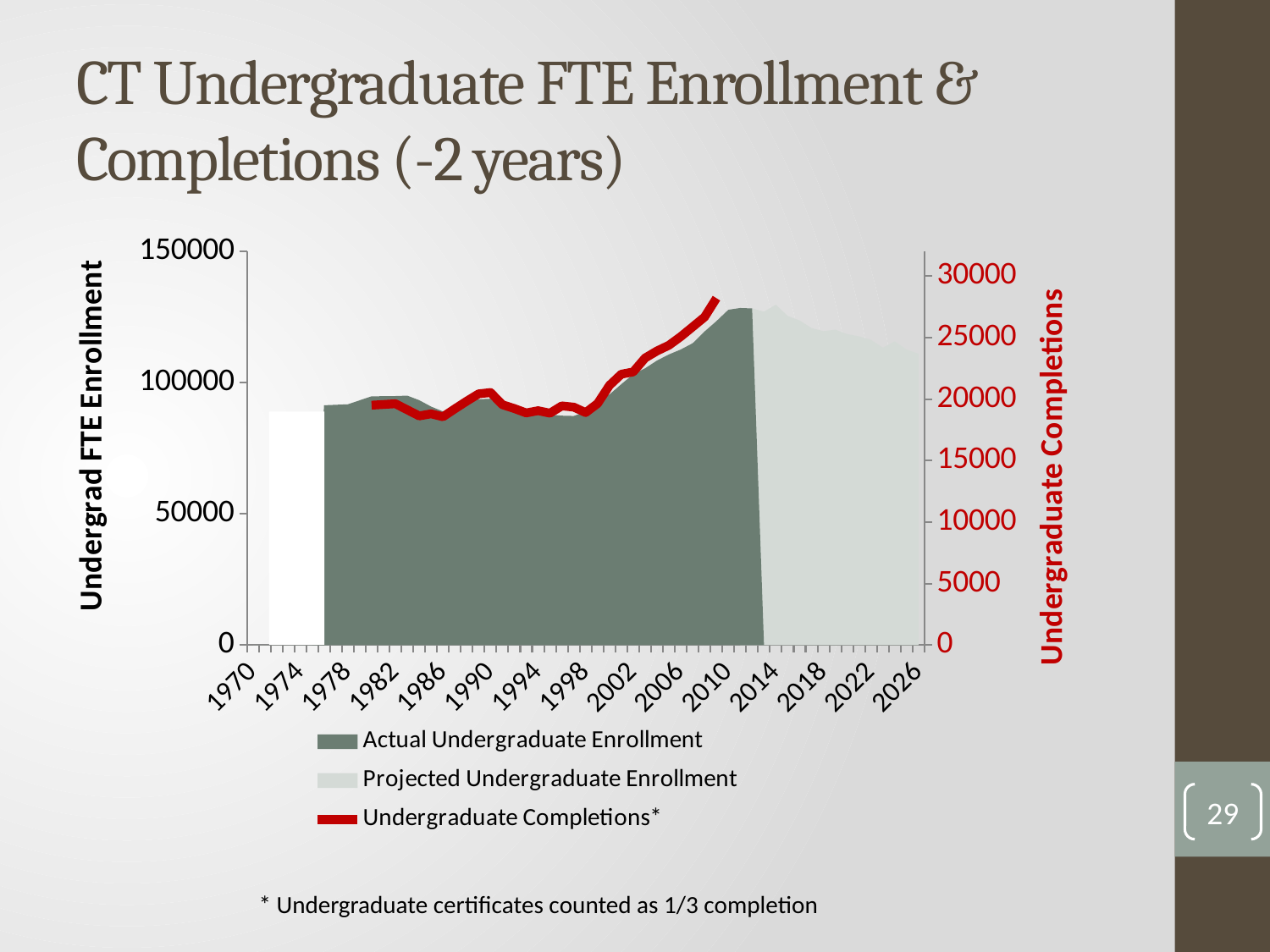
Does the Projected Undergraduate Enrollment rise or fall between 2014 and 2026? fall Is the Actual Undergraduate Enrollment value for 1978 greater or less than 100000? less What is the label of the right-hand vertical axis? Undergraduate Completions How many series does the legend list? 3 What kind of chart is shown on the slide? area chart with a line Is the Actual Undergraduate Enrollment value for 2010 greater or less than 100000? greater Is the Projected Undergraduate Enrollment value for 2026 greater or less than 100000? greater What is the title of the chart on the slide? CT Undergraduate FTE Enrollment & Completions (-2 years) Which is larger, the Actual Undergraduate Enrollment in 2010 or in 1978? 2010 Do the Undergraduate Completions values rise or fall between 1998 and 2010? rise